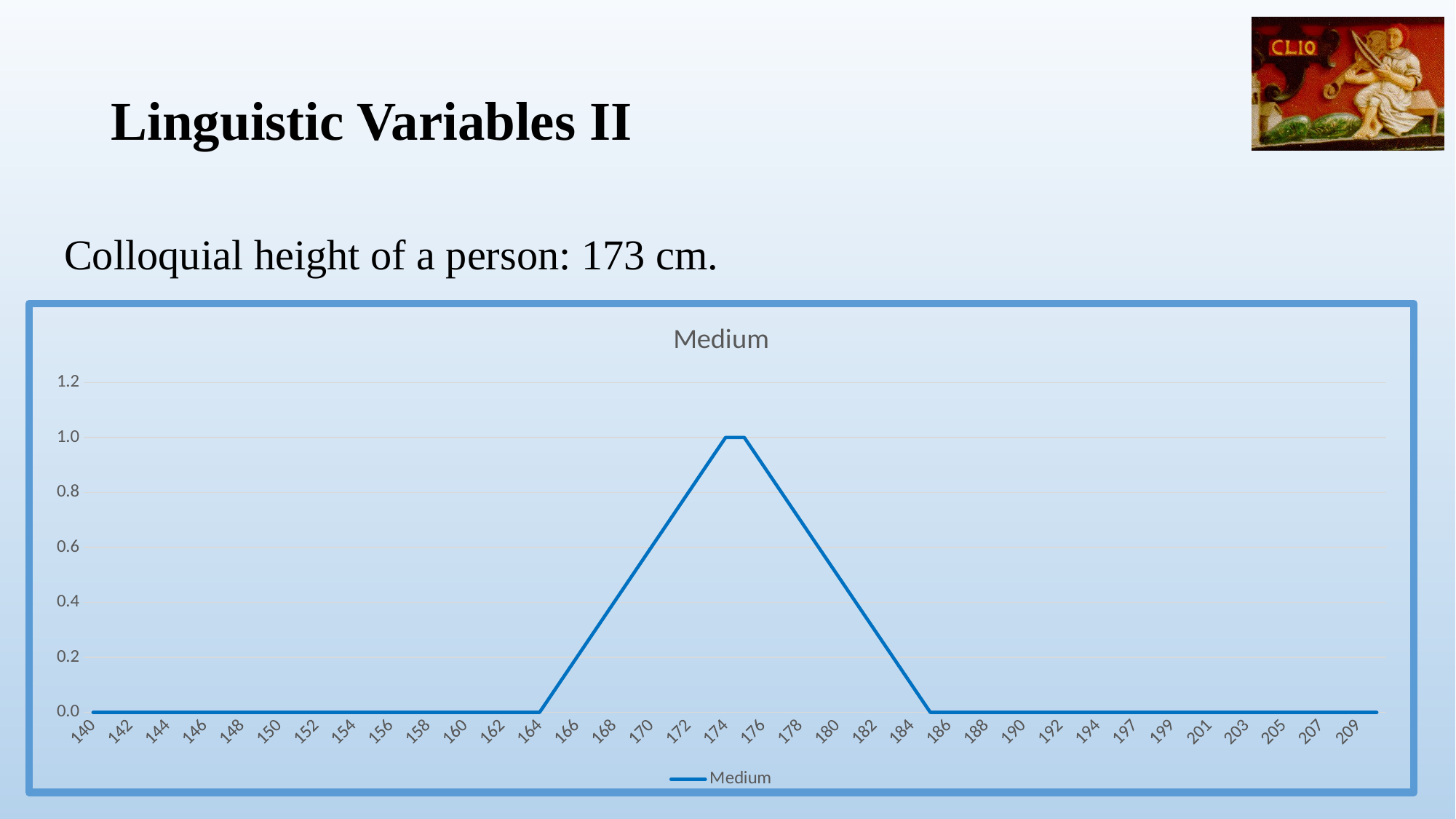
What is the value of the Medium series at 190? 0.0 What is the value of the Medium series at 174? 1.0 Is the value of the Medium series at 166 greater or less than 0.4? less What is the value of the Medium series at 140? 0.0 Which has the larger value in the Medium series, 174 or 150? 174 Is the value of the Medium series at 172 greater or less than 0.6? greater What kind of chart is shown on the slide? line chart How many series does the legend list? 1 At which labelled x value does the Medium series reach its highest value? 174 What is the title of the chart? Medium Is the value of the Medium series at 182 greater or less than 0.6? less Does the Medium series rise or fall between 174 and 186? fall